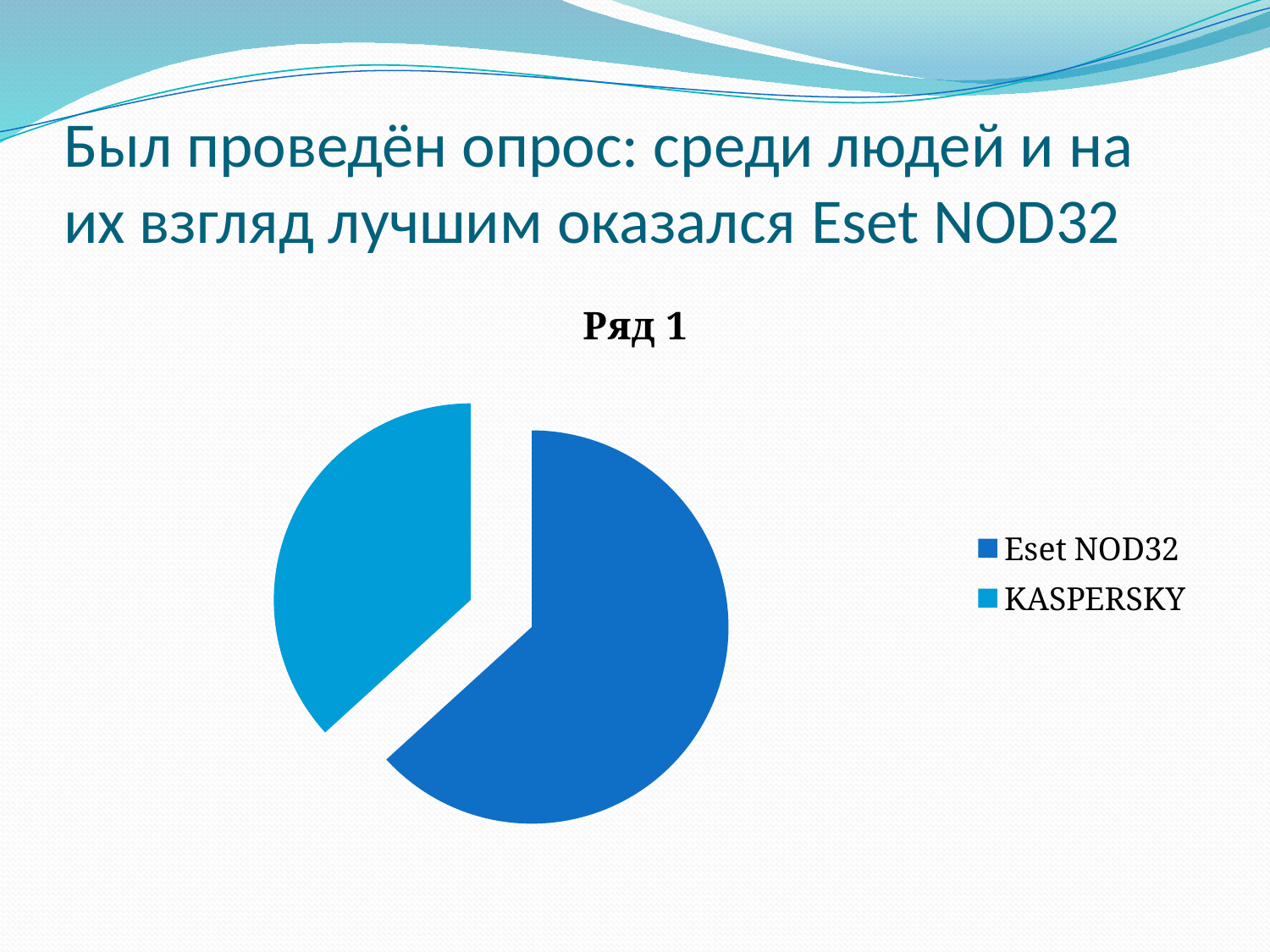
How many slices does the pie chart have? 2 How many entries does the chart legend list? 2 What is the title of the chart? Ряд 1 Which category is shown in the lighter blue colour? KASPERSKY Does the Eset NOD32 slice take up more or less than half of the pie? more Which category has the smallest slice of the pie? KASPERSKY Does the KASPERSKY slice take up more or less than half of the pie? less What kind of chart is shown on the slide? pie chart Which category has the largest slice of the pie? Eset NOD32 Which slice is larger, Eset NOD32 or KASPERSKY? Eset NOD32